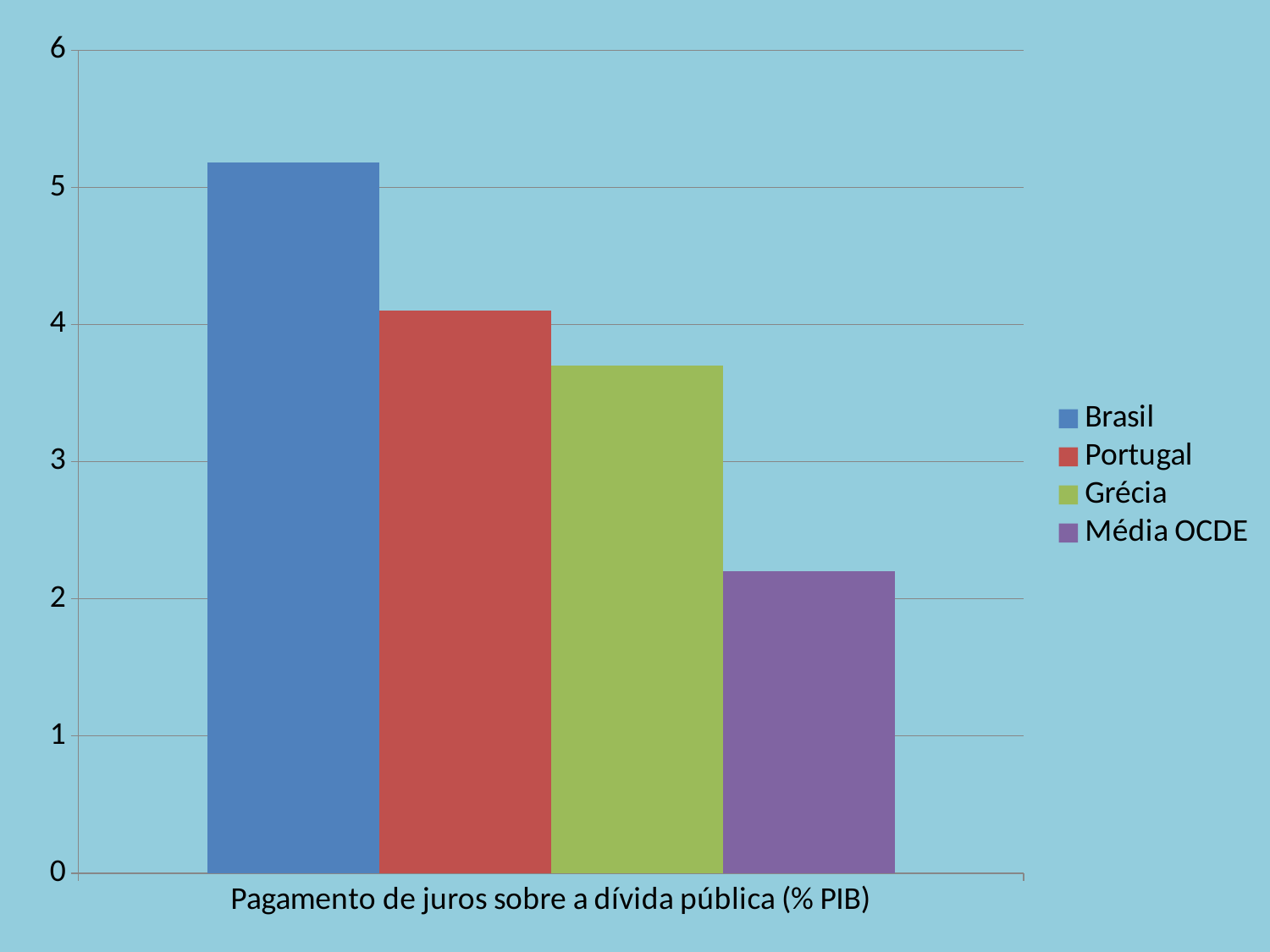
Is the value for Brasil greater or less than 5? greater Is the value for Grécia greater or less than 4? less What colour is the bar for Brasil? blue Is the value for Média OCDE greater or less than 3? less Which series has the lowest value? Média OCDE How many bars are plotted in the chart? 4 What kind of chart is shown on the slide? bar chart Which is larger, the value for Grécia or the value for Média OCDE? Grécia What is the label shown on the horizontal axis of the chart? Pagamento de juros sobre a dívida pública (% PIB) Which series has the highest value? Brasil How many series does the legend list? 4 Which is larger, the value for Brasil or the value for Portugal? Brasil